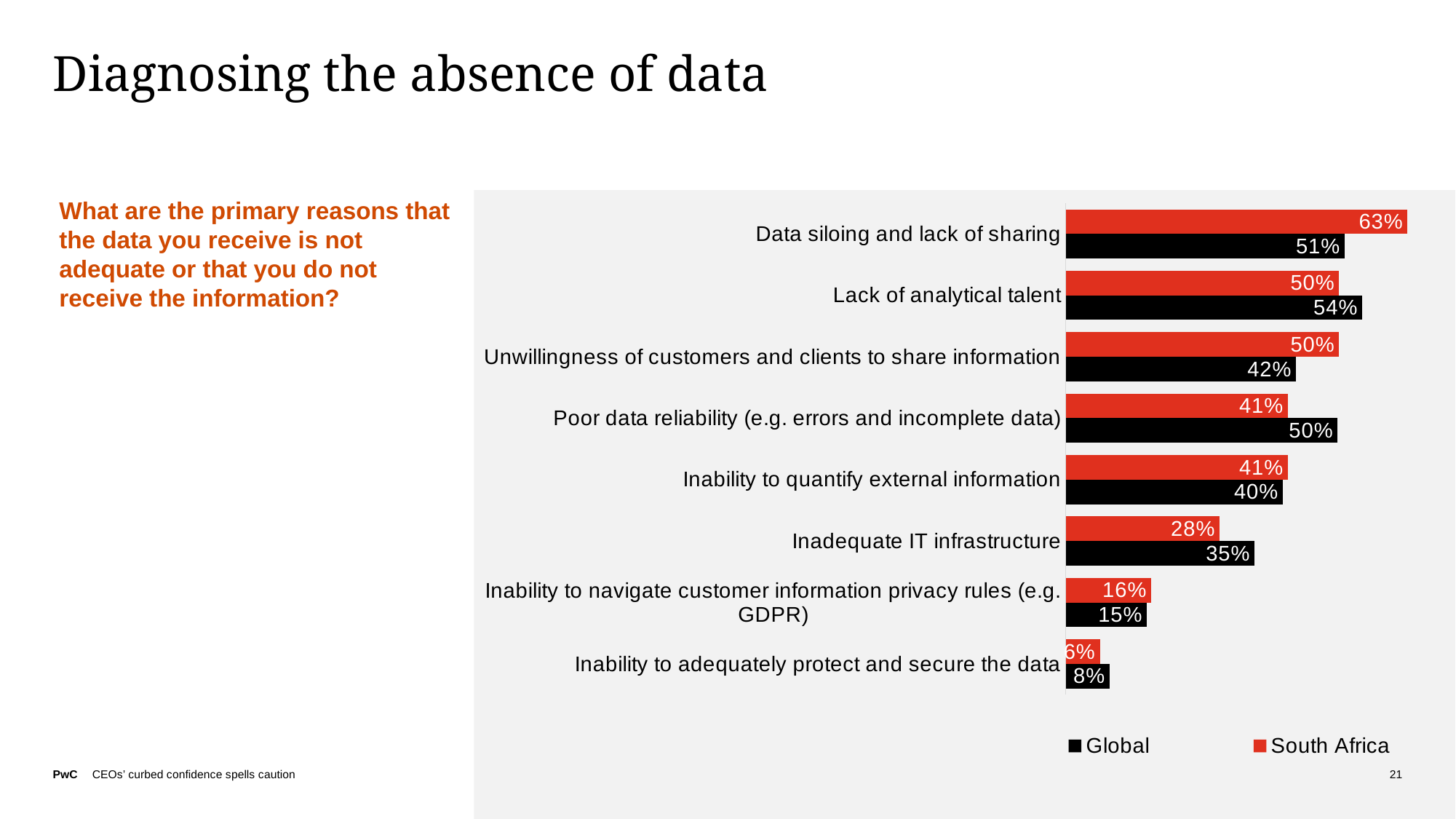
Which category has the highest South Africa value? Data siloing and lack of sharing Which colour represents the South Africa series in the chart? Red What is the difference between the South Africa and Global values for Data siloing and lack of sharing? 12% How many categories are shown in the chart? 8 What is the South Africa value for Inability to navigate customer information privacy rules (e.g. GDPR)? 16% What kind of chart is shown on the slide? Bar chart Which category has the lowest Global value? Inability to adequately protect and secure the data What is the South Africa value for Data siloing and lack of sharing? 63% What is the Global value for Lack of analytical talent? 54% What is the Global value for Inadequate IT infrastructure? 35% For Poor data reliability (e.g. errors and incomplete data), which is larger: the Global value or the South Africa value? Global How many series does the legend list? 2